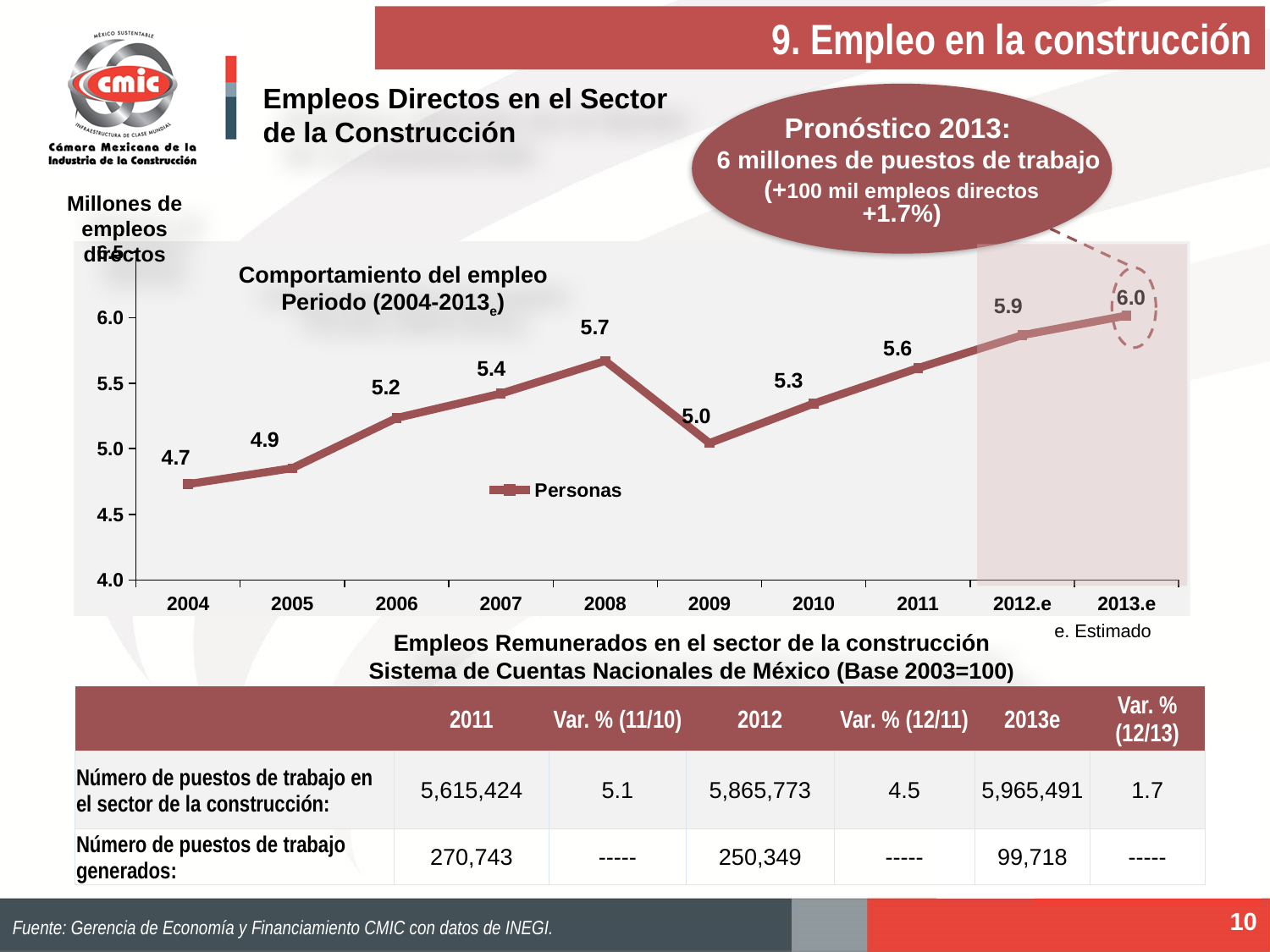
How many series does the legend of the line chart list? 1 What is the value for 2004 in the line chart? 4.7 Which is larger in the line chart, the value for 2007 or the value for 2010? 2007 What kind of chart is shown on the slide? line chart Which year has the highest value in the line chart? 2013.e What is the difference between the values for 2008 and 2009 in the line chart? 0.7 Which year has the lowest value in the line chart? 2004 What is the value for 2009 in the line chart? 5.0 What is the name of the series shown in the legend of the line chart? Personas What is the value for 2008 in the line chart? 5.7 Is the value for 2011 in the line chart greater or less than 5.5? greater How many years are plotted on the x axis of the line chart? 10